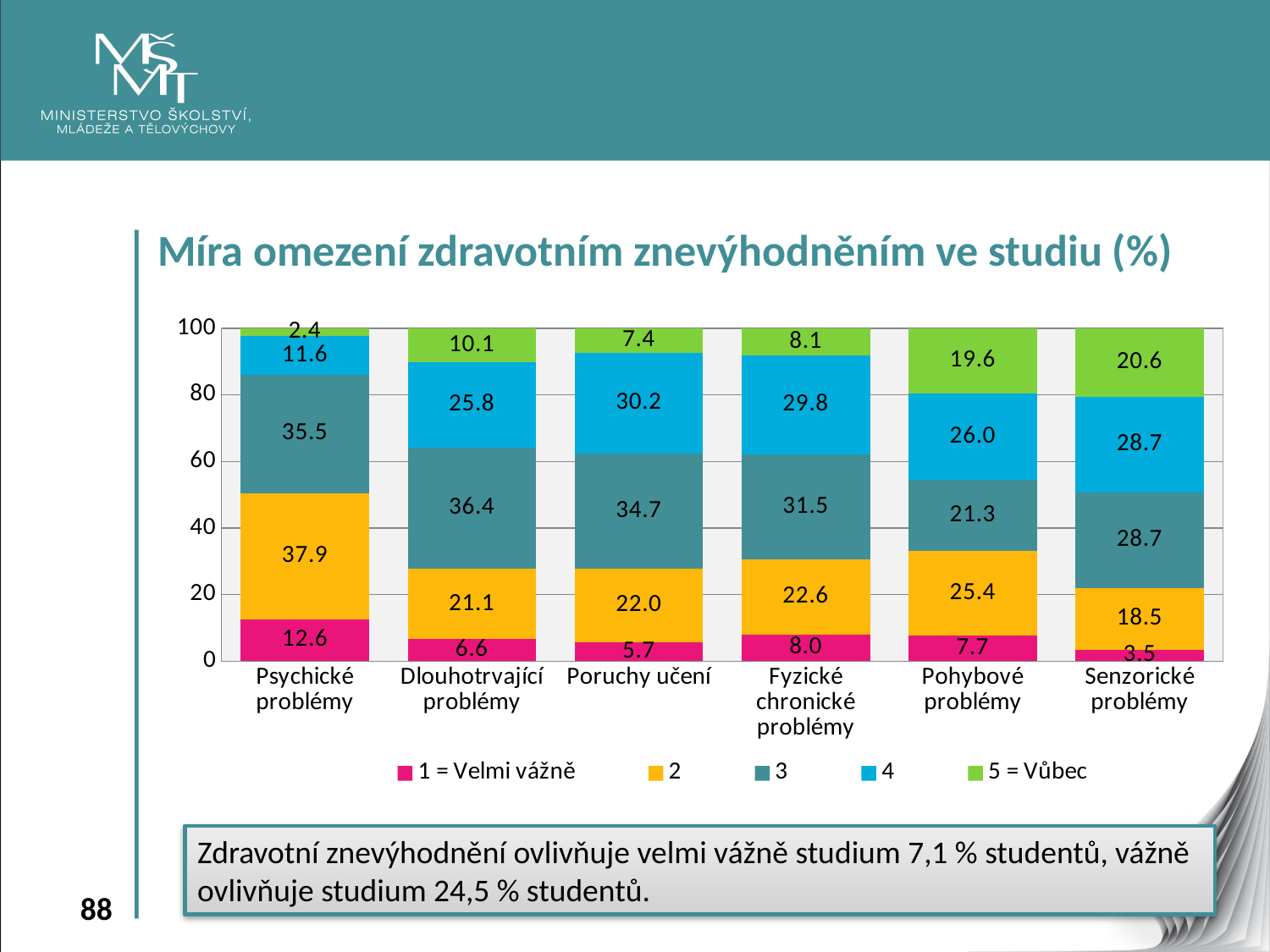
Which category has the highest value in the "1 = Velmi vážně" series? Psychické problémy What is the difference between the series 2 values for Psychické problémy and Senzorické problémy? 19.4 What is the value of the "5 = Vůbec" series for Senzorické problémy? 20.6 What is the value of series 4 for Pohybové problémy? 26.0 What kind of chart is shown on the slide? Stacked bar chart Which category has the highest value in the "5 = Vůbec" series? Senzorické problémy What is the value of the "1 = Velmi vážně" series for Psychické problémy? 12.6 Which category has the lowest value in the "1 = Velmi vážně" series? Senzorické problémy Which has the larger series 3 value: Dlouhotrvající problémy or Poruchy učení? Dlouhotrvající problémy What is the title of the chart? Míra omezení zdravotním znevýhodněním ve studiu (%) How many categories are shown on the x axis? 6 How many series does the legend list? 5